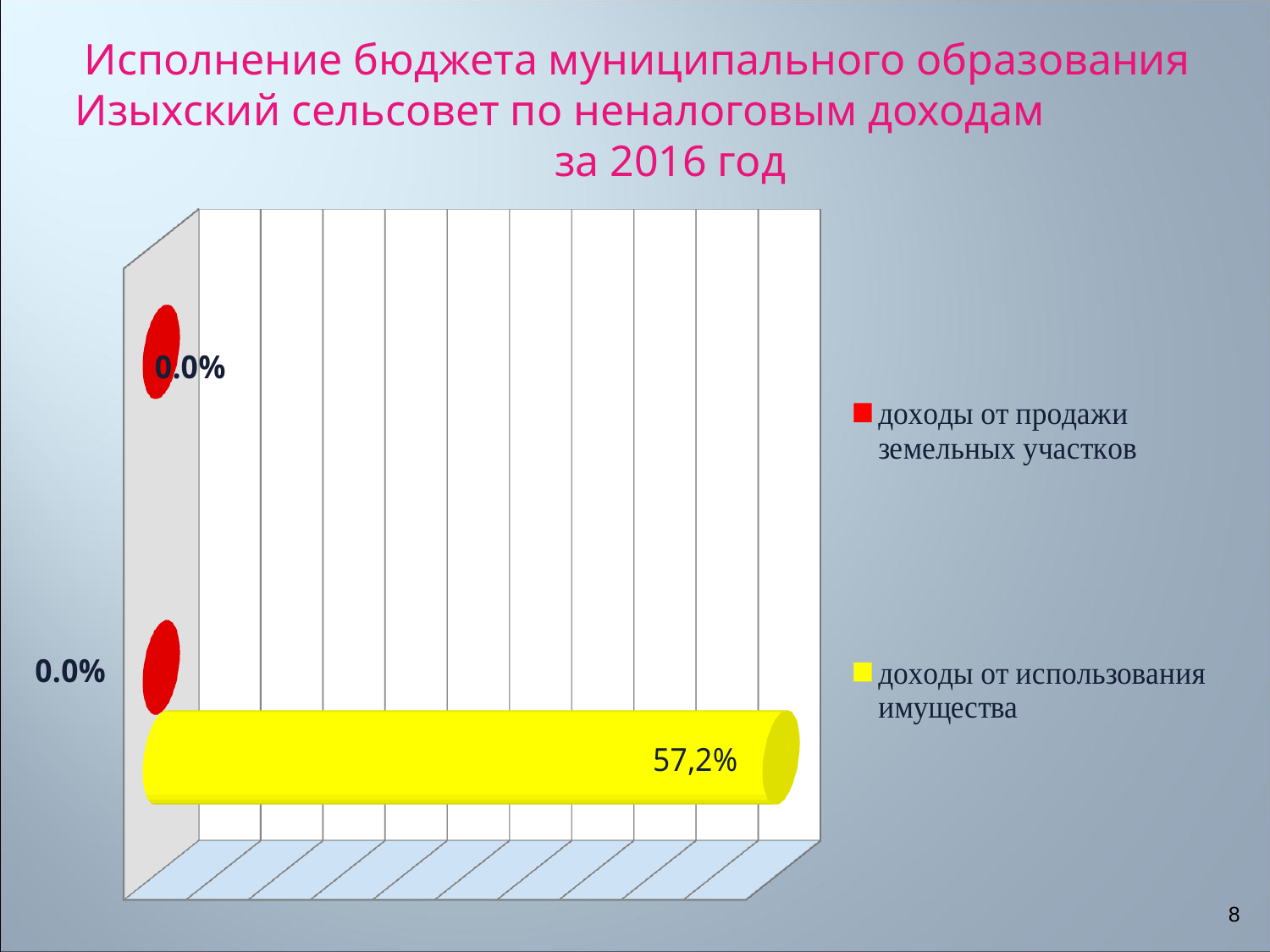
What is the title of the slide containing the chart? Исполнение бюджета муниципального образования Изыхский сельсовет по неналоговым доходам за 2016 год What value is shown for доходы от использования имущества? 57,2% Which series has the higher value: доходы от продажи земельных участков or доходы от использования имущества? доходы от использования имущества What value is shown for доходы от продажи земельных участков? 0.0% Which series has the lowest value on the chart? доходы от продажи земельных участков How many series does the legend list? 2 What kind of chart is shown on the slide? bar chart What is the difference between the value for доходы от использования имущества and the value for доходы от продажи земельных участков? 57,2% How many data labels on the chart read 0.0%? 2 What colour represents доходы от использования имущества in the chart? yellow Which series has the highest value on the chart? доходы от использования имущества